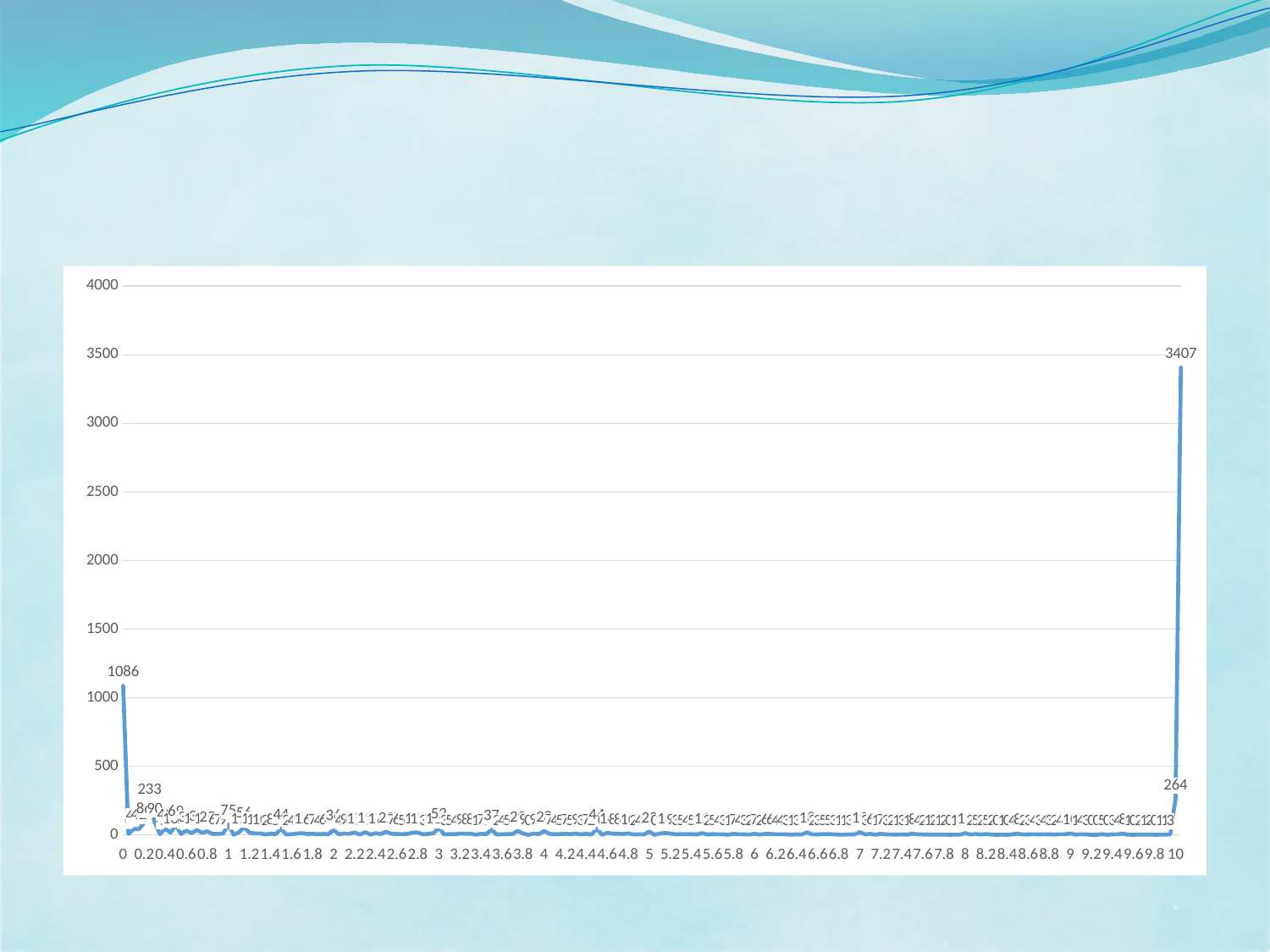
What is the interval between consecutive y-axis ticks? 500 What kind of chart is shown on the slide? line chart Does the line end higher or lower than it starts? higher Is the value at x = 2 greater or less than 1000? less What is the highest tick value shown on the y axis? 4000 Is the value at x = 5 greater or less than 500? less What is the highest value labelled on the chart? 3407 What is the value labelled at the start of the line, at x = 0? 1086